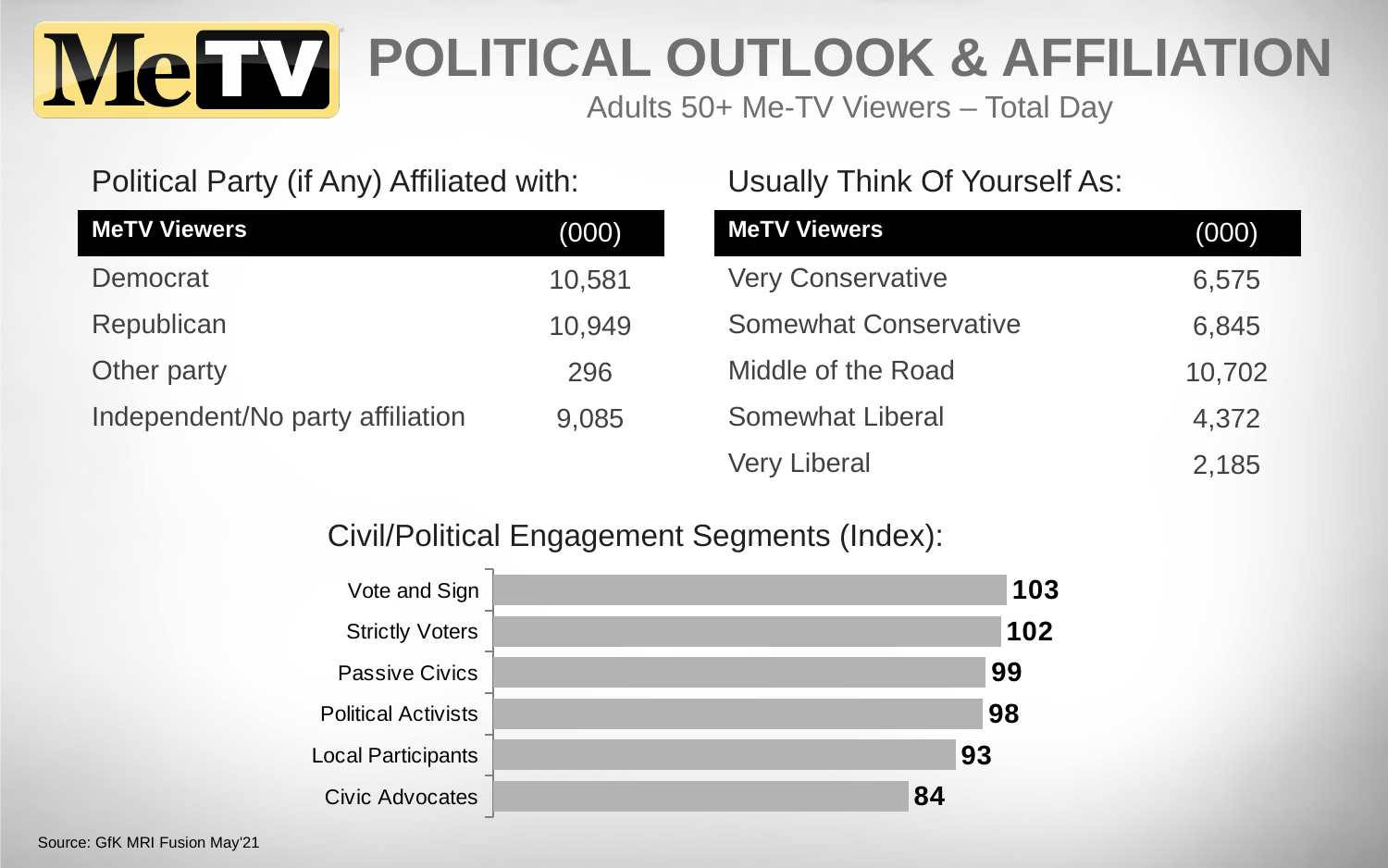
In the Civil/Political Engagement Segments chart, what is the index value for Political Activists? 98 In the Civil/Political Engagement Segments chart, which segment has the lowest index? Civic Advocates In the Civil/Political Engagement Segments chart, what is the index value for Vote and Sign? 103 In the Civil/Political Engagement Segments chart, which segment has the highest index? Vote and Sign In the Civil/Political Engagement Segments chart, which has a higher index: Local Participants or Passive Civics? Passive Civics In the Civil/Political Engagement Segments chart, what is the index value for Civic Advocates? 84 In the Civil/Political Engagement Segments chart, what is the difference between the index for Vote and Sign and the index for Civic Advocates? 19 In the Civil/Political Engagement Segments chart, what is the index value for Local Participants? 93 In the Civil/Political Engagement Segments chart, what is the index value for Strictly Voters? 102 In the Civil/Political Engagement Segments chart, what is the index value for Passive Civics? 99 What type of chart is used for the Civil/Political Engagement Segments (Index)? Bar chart How many segments are shown in the Civil/Political Engagement Segments chart? 6